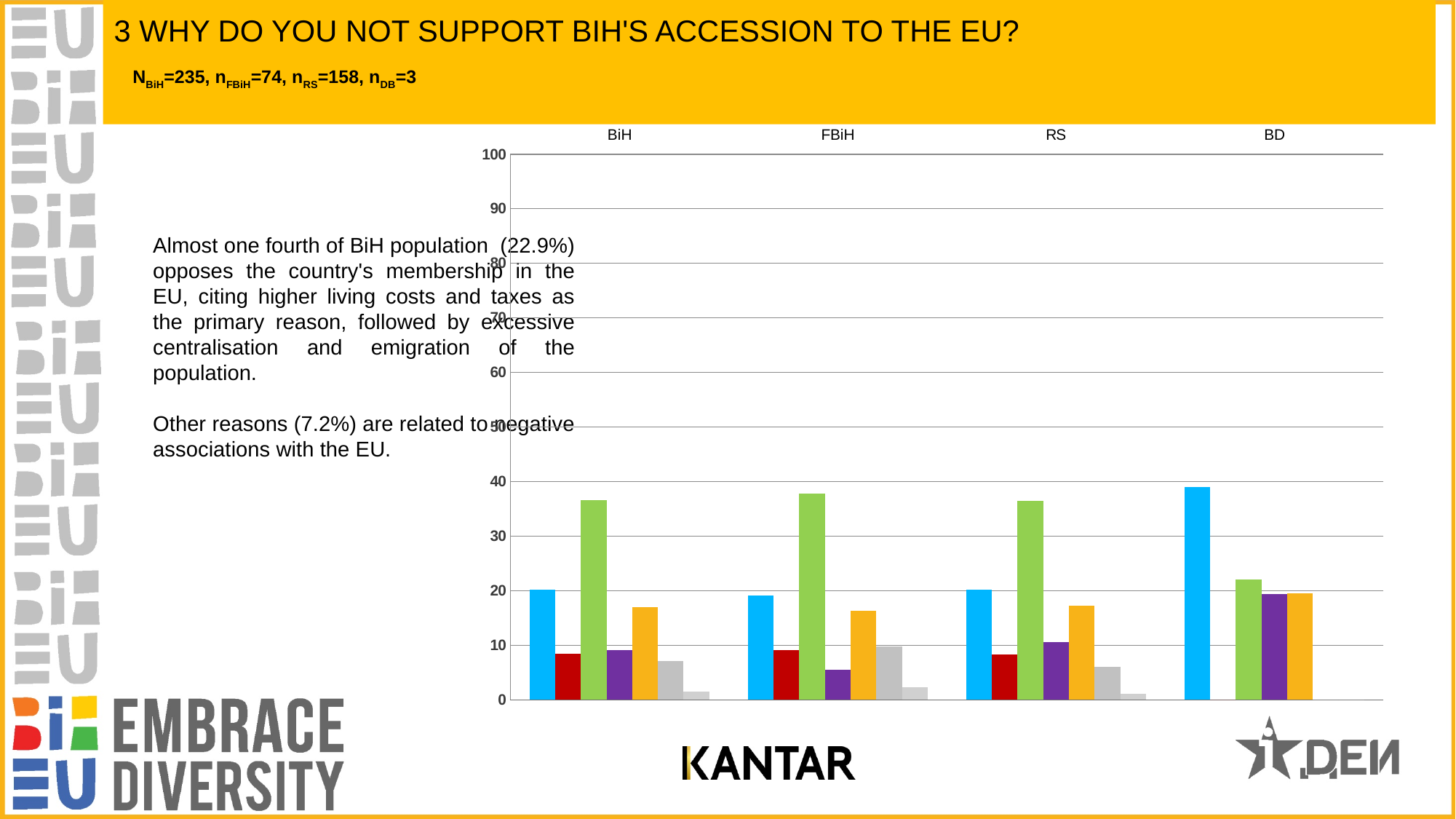
Which is larger, the blue bar for BD or the blue bar for BiH? the blue bar for BD For BiH, which is larger, the green bar or the orange bar? the green bar How many categories are shown along the x axis of the chart? 4 Is the value of the green bar for BiH greater or less than 30? greater Is the value of the blue bar for BD greater or less than 30? greater Is the value of the green bar for BD greater or less than 30? less What kind of chart is shown on the slide? bar chart Which category has the tallest blue bar? BD Which category labels appear along the top of the chart? BiH, FBiH, RS, BD For RS, which is larger, the orange bar or the purple bar? the orange bar